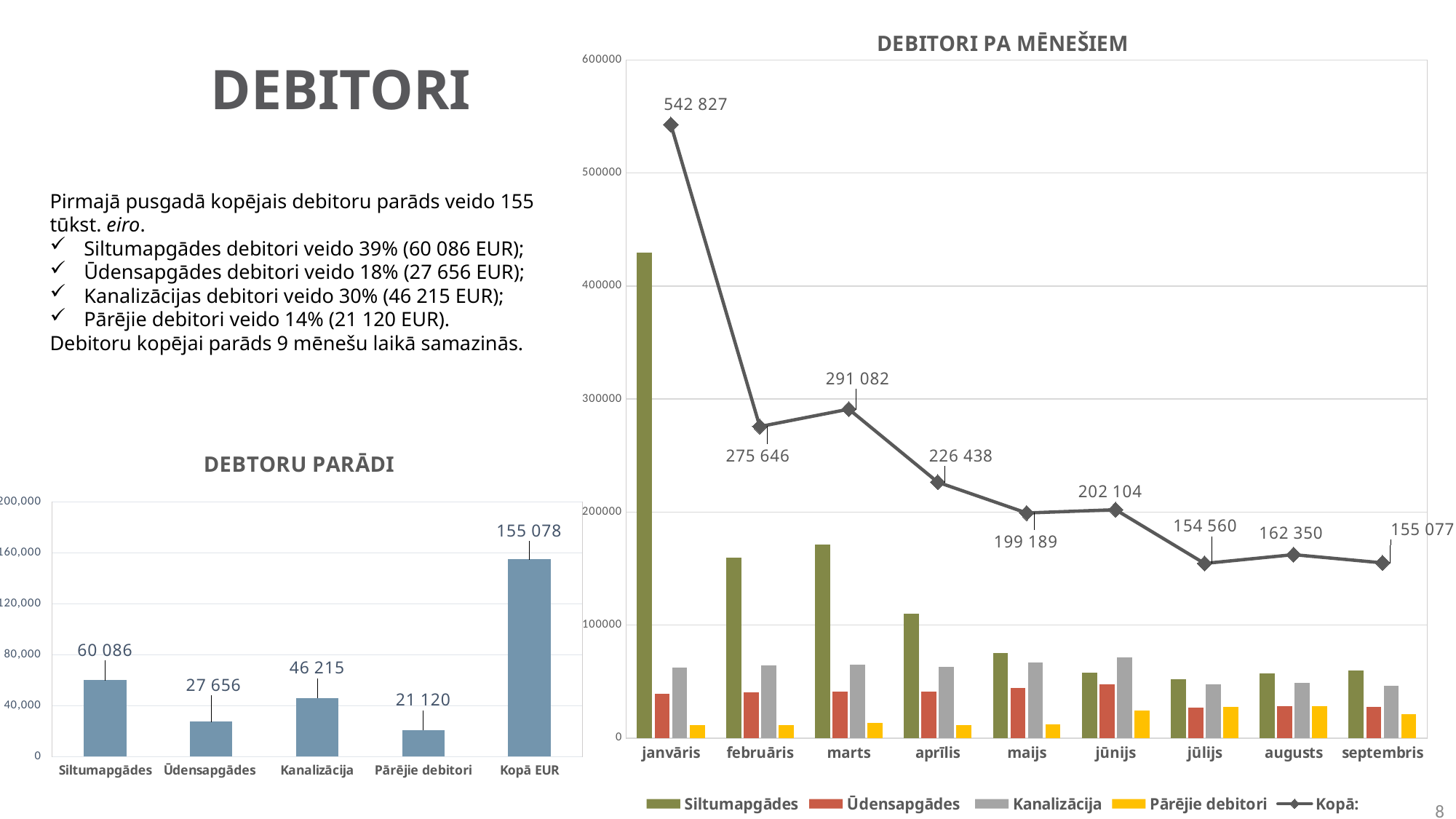
In the DEBITORI PA MĒNEŠIEM chart, does the Kopā line generally rise or fall from janvāris to septembris? fall In the DEBITORI PA MĒNEŠIEM chart, is the Siltumapgādes bar for janvāris greater or less than 400000? greater In the DEBITORI PA MĒNEŠIEM chart, is the Kopā value for februāris or marts larger? marts In the DEBTORU PARĀDI chart, which category other than Kopā EUR has the lowest value? Pārējie debitori In the DEBTORU PARĀDI chart, what is the difference between Kanalizācija and Ūdensapgādes? 18 559 In the DEBTORU PARĀDI chart, how many bars are plotted? 5 In the DEBTORU PARĀDI chart, what is the value for Siltumapgādes? 60 086 In the DEBITORI PA MĒNEŠIEM chart, which month has the lowest Kopā value? jūlijs In the DEBITORI PA MĒNEŠIEM chart, how many series does the legend list? 5 In the DEBITORI PA MĒNEŠIEM chart, what is the Kopā value for janvāris? 542 827 In the DEBTORU PARĀDI chart, what is the value for Kopā EUR? 155 078 In the DEBITORI PA MĒNEŠIEM chart, what is the Kopā value for maijs? 199 189